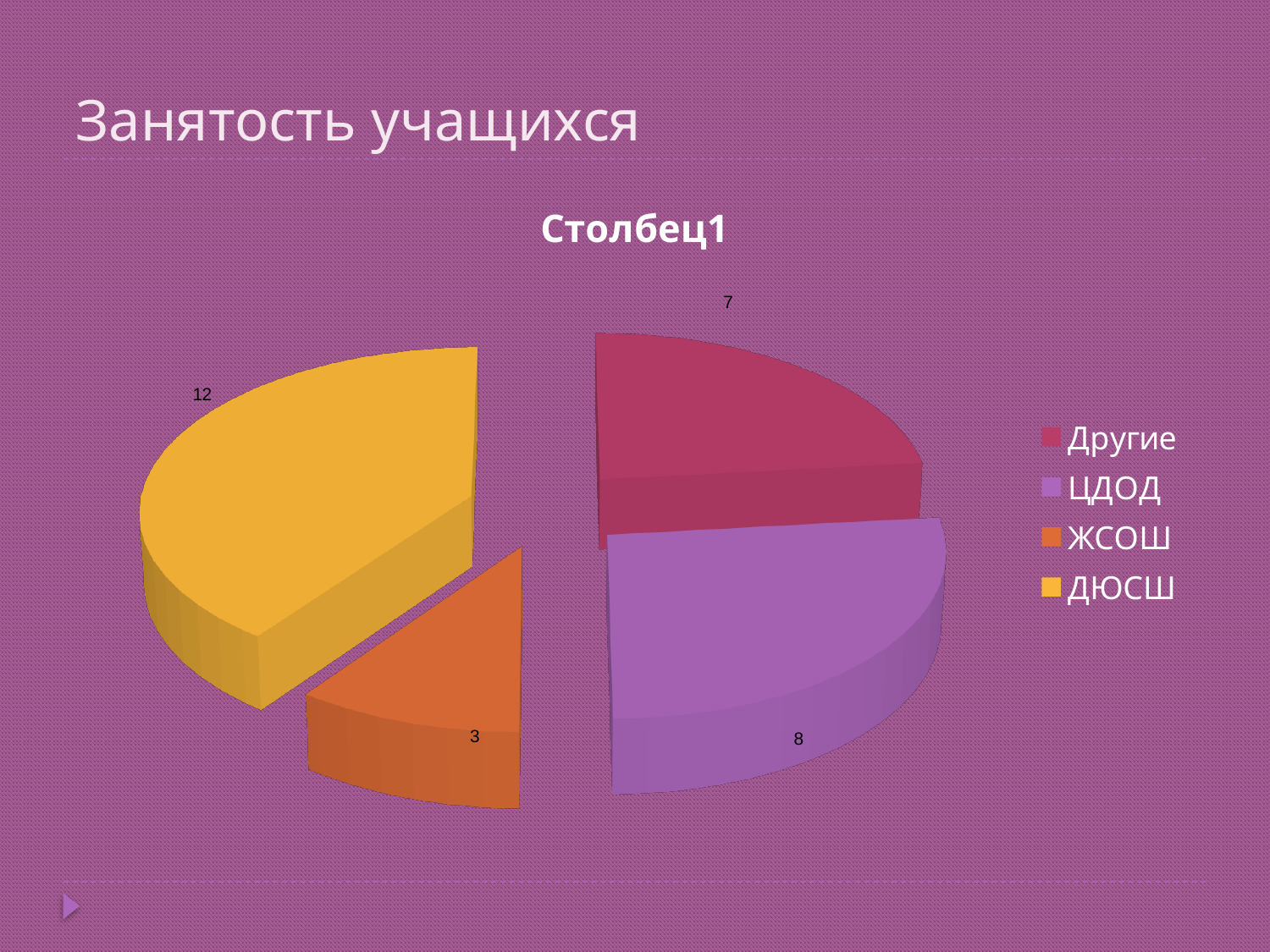
Which category has the smallest slice? ЖСОШ What is the title of the chart? Столбец1 What is the value for ЖСОШ? 3 Which is larger, the value for ЦДОД or the value for Другие? ЦДОД Which category has the largest slice? ДЮСШ What is the difference between the values for ДЮСШ and ЖСОШ? 9 How many slices does the pie chart have? 4 What is the value for Другие? 7 What is the value for ДЮСШ? 12 What type of chart is shown on the slide? Pie chart What is the value for ЦДОД? 8 What share of the pie does ДЮСШ represent? 40%